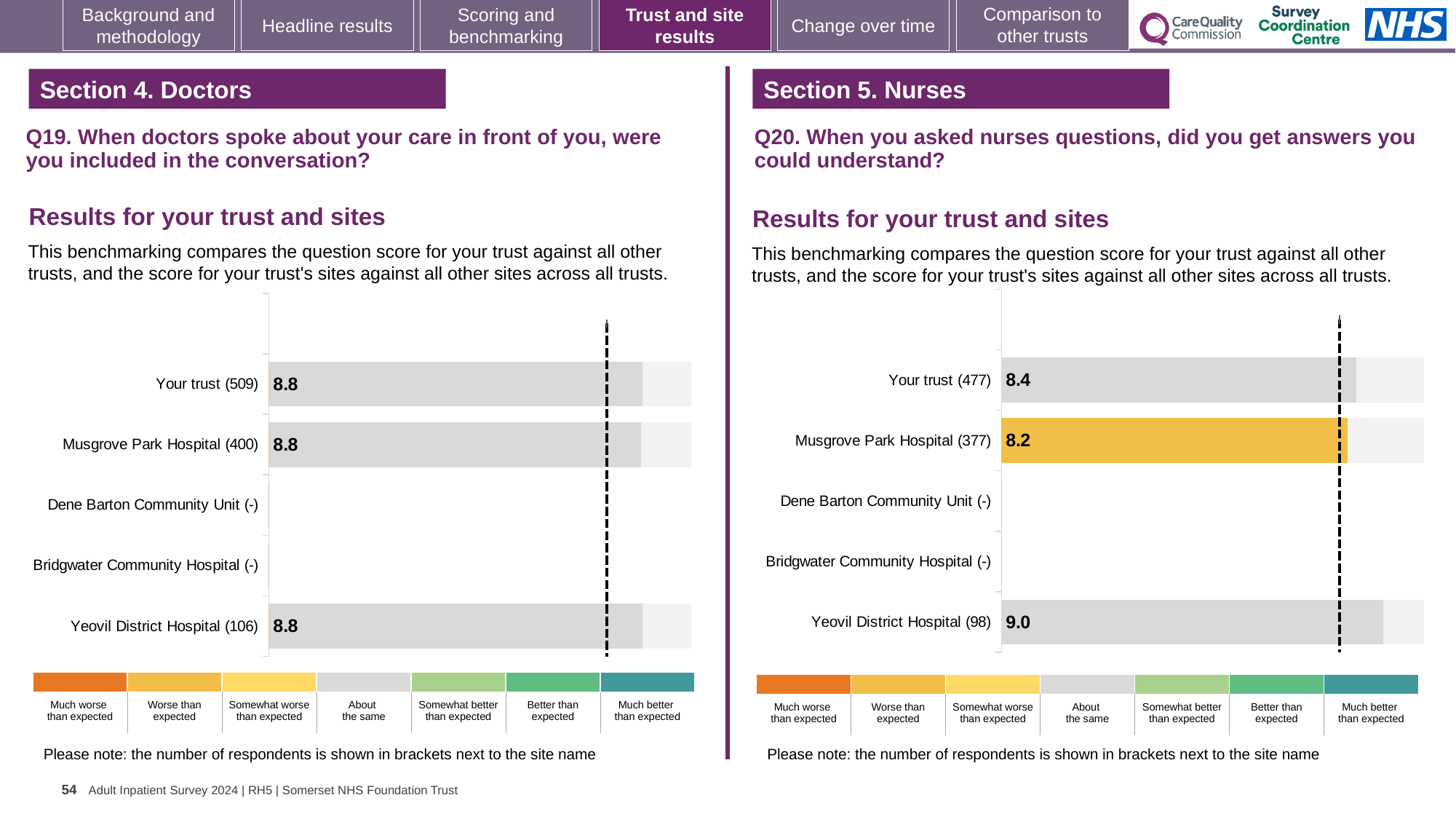
On the Q20 chart (right), which of the sites with a plotted score has the lowest score? Musgrove Park Hospital On the Q20 chart (right), which has the larger score, Your trust or Musgrove Park Hospital? Your trust On the Q20 chart (right), how many respondents are shown in brackets for Your trust? 477 On the Q20 chart (right), what is the score for Musgrove Park Hospital? 8.2 How many categories (rows) are listed on the Q19 chart (left)? 5 On the Q20 chart (right), what is the score for Your trust? 8.4 On the Q20 chart (right), which site has the highest score? Yeovil District Hospital On the Q19 chart (left), what is the score for Yeovil District Hospital? 8.8 On the Q19 chart (left), what is the score for Your trust? 8.8 On the Q20 chart (right), what is the difference between the scores for Yeovil District Hospital and Musgrove Park Hospital? 0.8 On the Q20 chart (right), what is the score for Yeovil District Hospital? 9.0 What kind of chart is used on the Q19 chart (left)? Bar chart